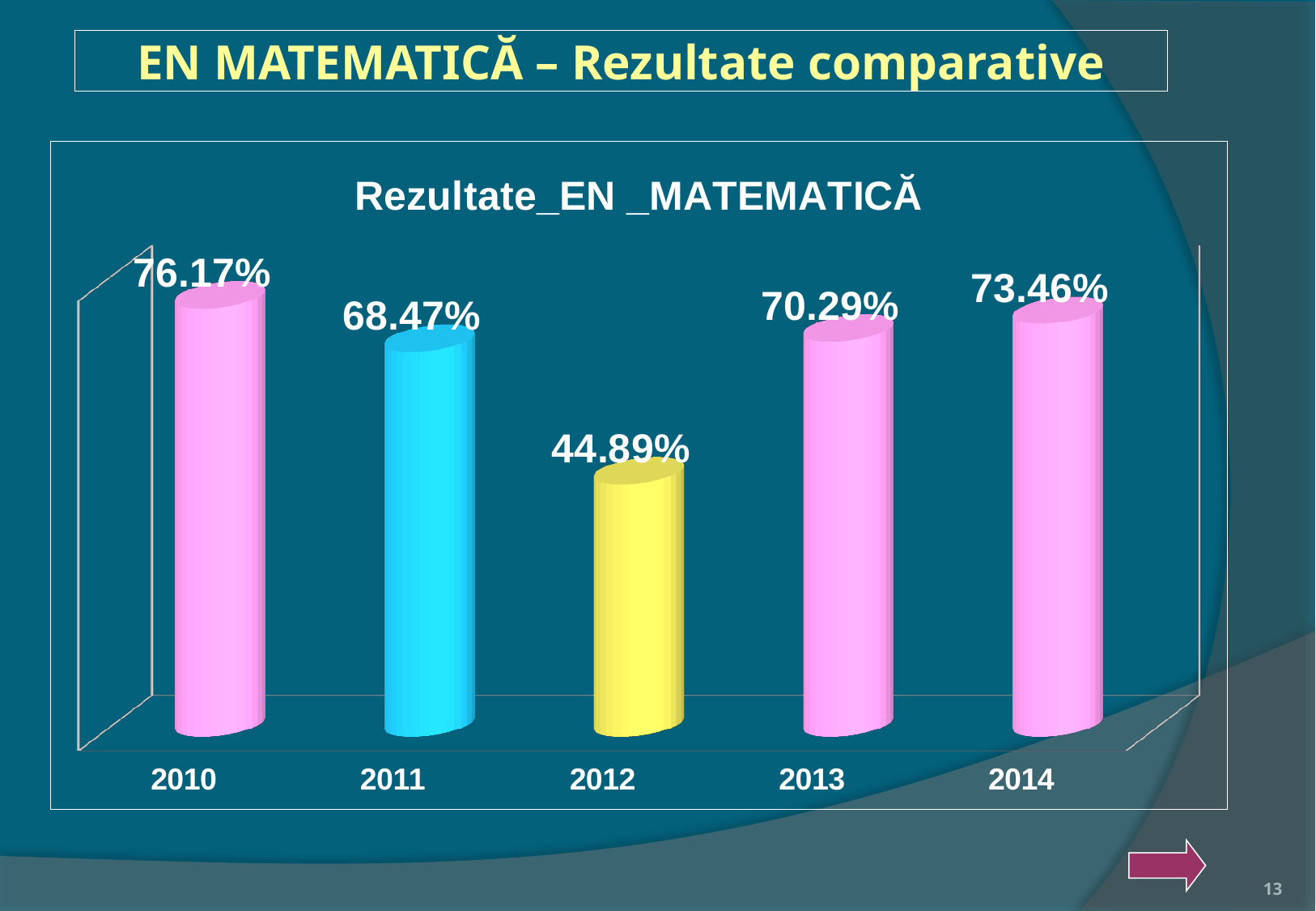
What is the difference between the values for 2010 and 2012? 31.28% What is the value for 2010? 76.17% What is the value for 2012? 44.89% Do the values rise or fall from 2012 to 2014? Rise What is the title of the chart? Rezultate_EN _MATEMATICĂ What is the difference between the values for 2014 and 2013? 3.17% Which year has the highest value? 2010 What kind of chart is this? Bar chart Which is larger, the value for 2011 or the value for 2013? 2013 What is the value for 2014? 73.46% How many years are shown on the chart? 5 Which year has the lowest value? 2012